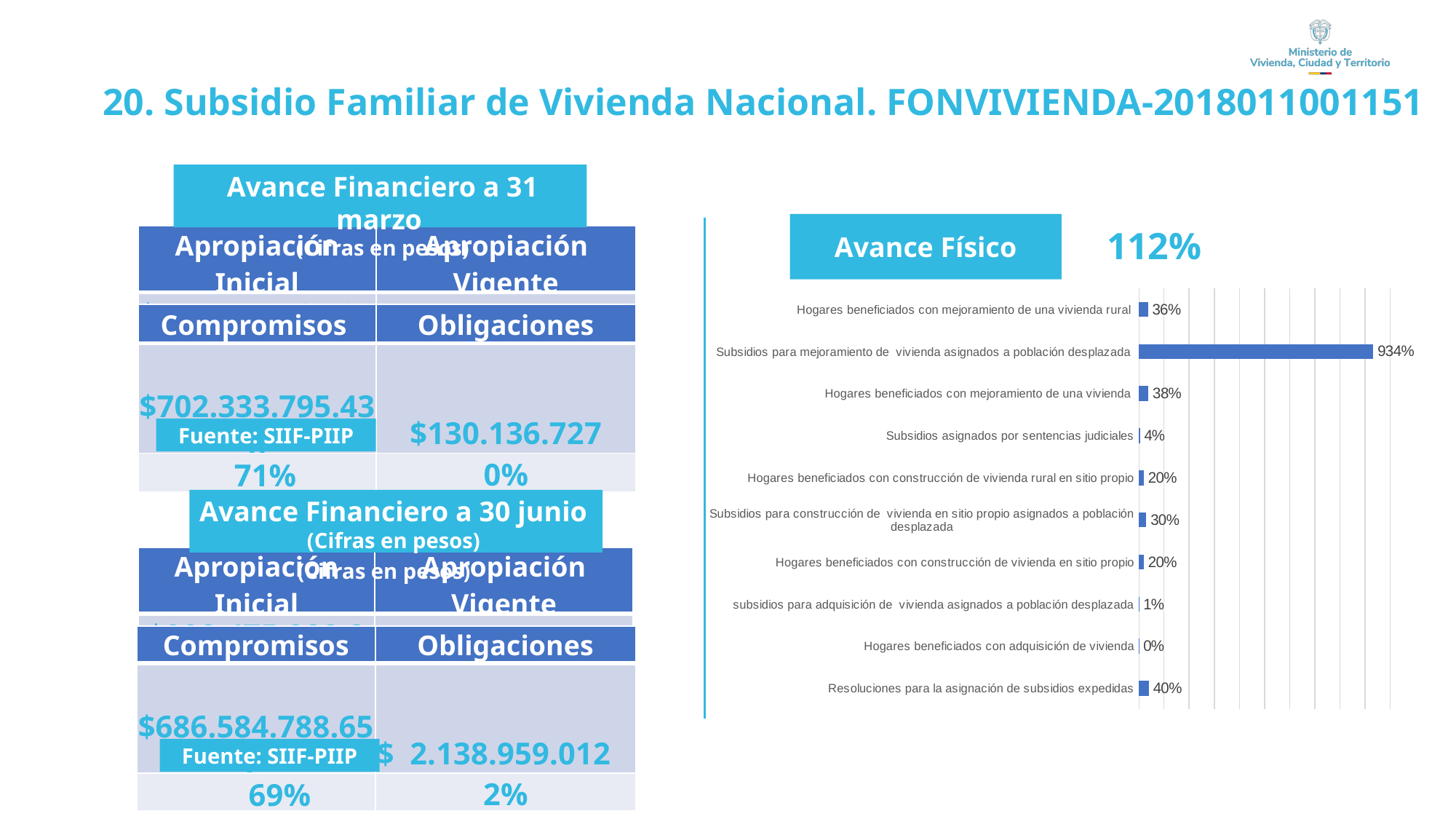
In the Avance Físico chart, which is larger: the value for "Subsidios para construcción de vivienda en sitio propio asignados a población desplazada" or the value for "Hogares beneficiados con construcción de vivienda en sitio propio"? Subsidios para construcción de vivienda en sitio propio asignados a población desplazada In the Avance Físico chart, what is the value for "Subsidios para mejoramiento de vivienda asignados a población desplazada"? 934% In the Avance Físico chart, what is the difference between the values for "Resoluciones para la asignación de subsidios expedidas" and "Hogares beneficiados con mejoramiento de una vivienda"? 2% What is the heading shown above the bar chart on the right side of the slide? Avance Físico In the Avance Físico chart, what is the value for "Subsidios asignados por sentencias judiciales"? 4% In the Avance Físico chart, what is the value for "subsidios para adquisición de vivienda asignados a población desplazada"? 1% How many categories are plotted in the Avance Físico chart? 10 In the Avance Físico chart, what is the value for "Hogares beneficiados con mejoramiento de una vivienda rural"? 36% What type of chart is shown under the heading "Avance Físico"? bar chart In the Avance Físico chart, which category has the highest value? Subsidios para mejoramiento de vivienda asignados a población desplazada In the Avance Físico chart, what is the value for "Resoluciones para la asignación de subsidios expedidas"? 40% In the Avance Físico chart, which category has the lowest value? Hogares beneficiados con adquisición de vivienda